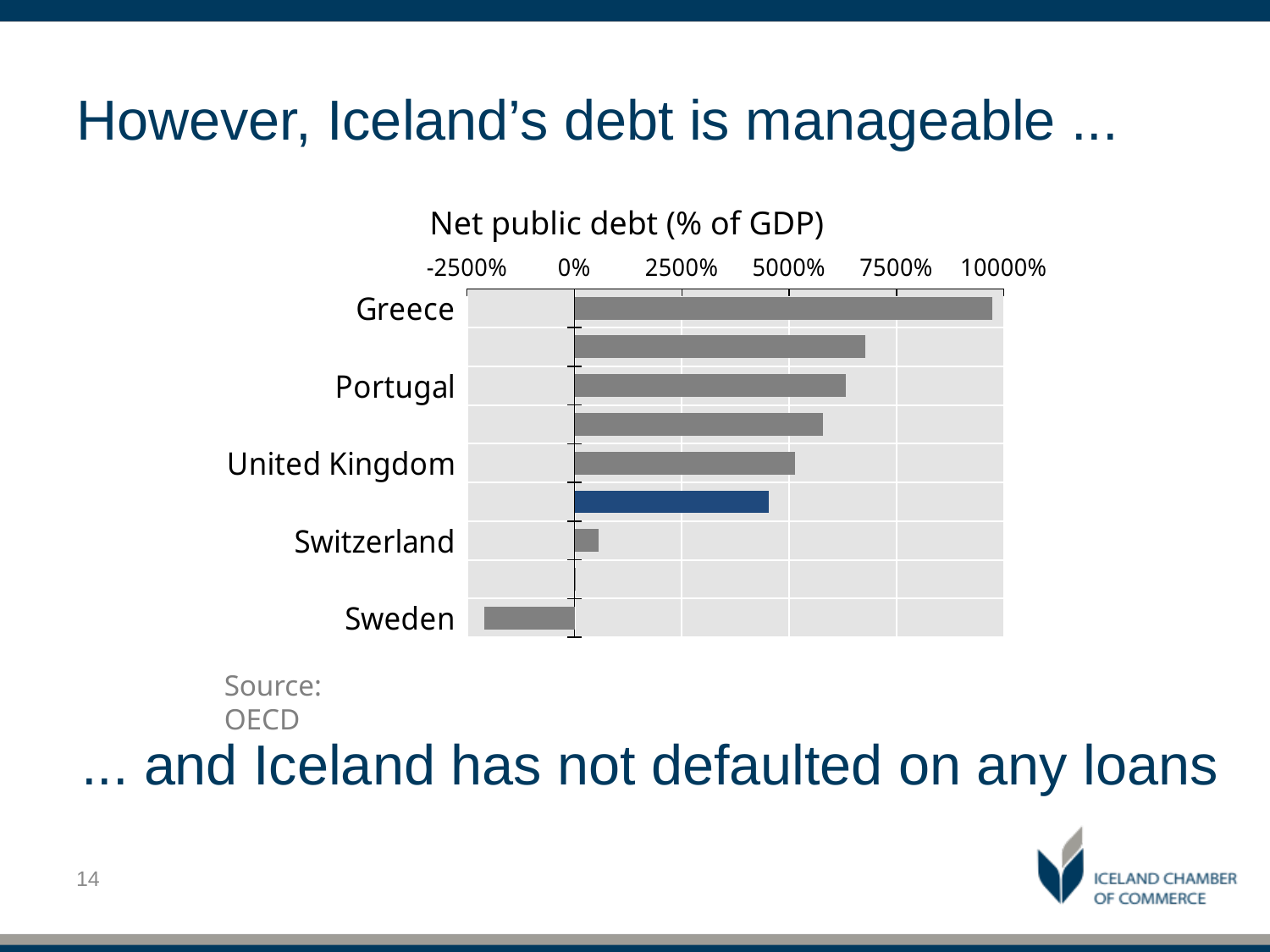
Is the value for Switzerland greater or less than 2500%? less Is the value for Greece greater or less than 7500%? greater What type of chart is shown on the slide? Bar chart Is the value for Sweden greater or less than 0%? less How many bars are plotted in the chart? 9 Which labelled country has the lowest net public debt in the chart? Sweden What is the title of the chart? Net public debt (% of GDP) Which labelled country has the highest net public debt in the chart? Greece Which has a higher net public debt, Switzerland or Sweden? Switzerland Which has a higher net public debt, Greece or Portugal? Greece